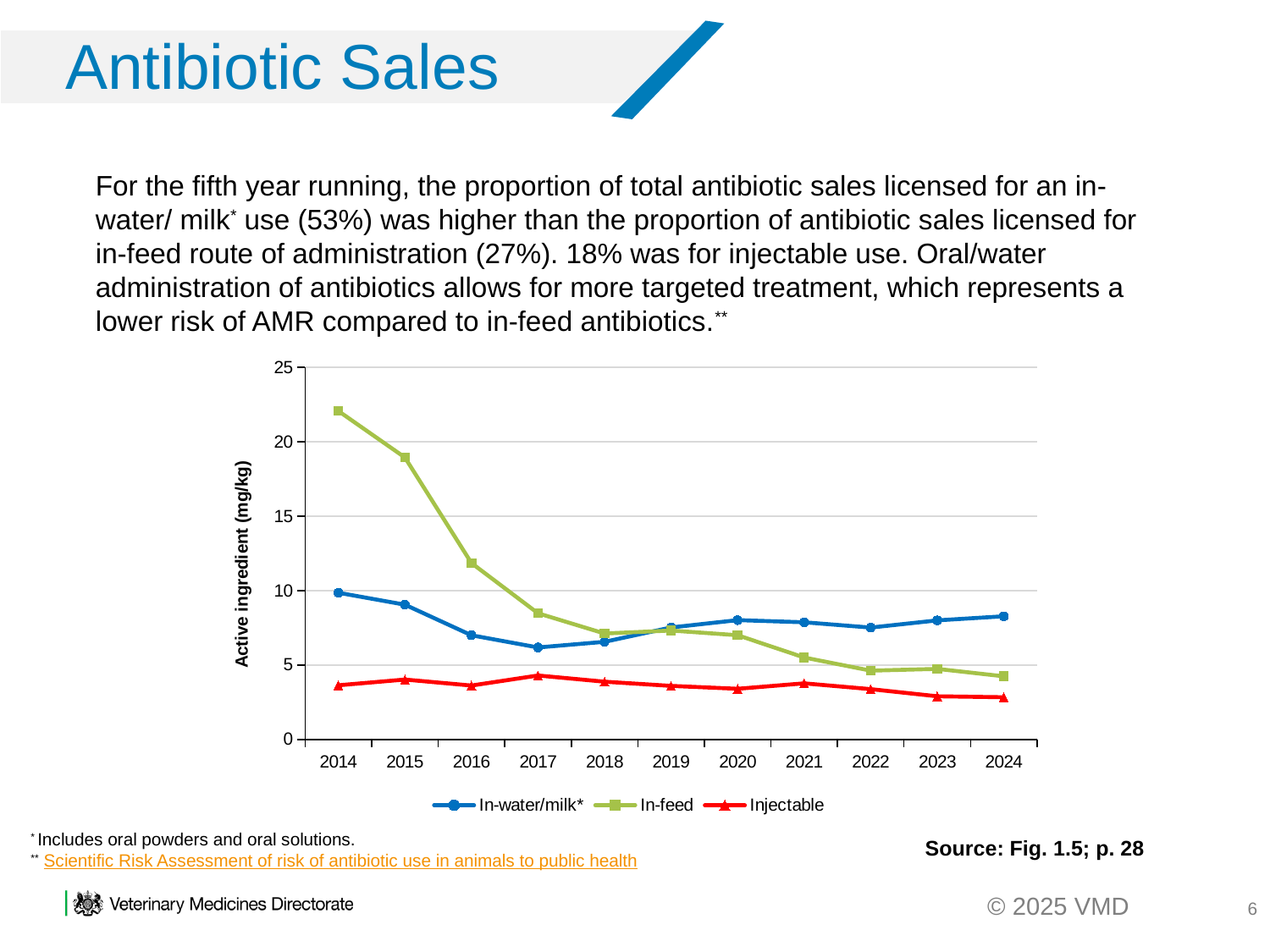
How many series does the chart's legend list? 3 Is the value for In-feed in 2014 greater or less than 20? greater Does the In-feed series rise or fall from 2014 to 2024? Fall In 2021, which is larger: the In-water/milk* value or the In-feed value? In-water/milk* Which series has the highest value in 2014? In-feed How many years are plotted along the x axis of the chart? 11 What is the label on the y axis of the chart? Active ingredient (mg/kg) Which series has the lowest value in 2024? Injectable What kind of chart is shown on the slide? Line chart Is the value for Injectable in 2024 greater or less than 5? less Is the value for In-feed in 2016 greater or less than 10? greater What colour is the Injectable line in the chart? Red